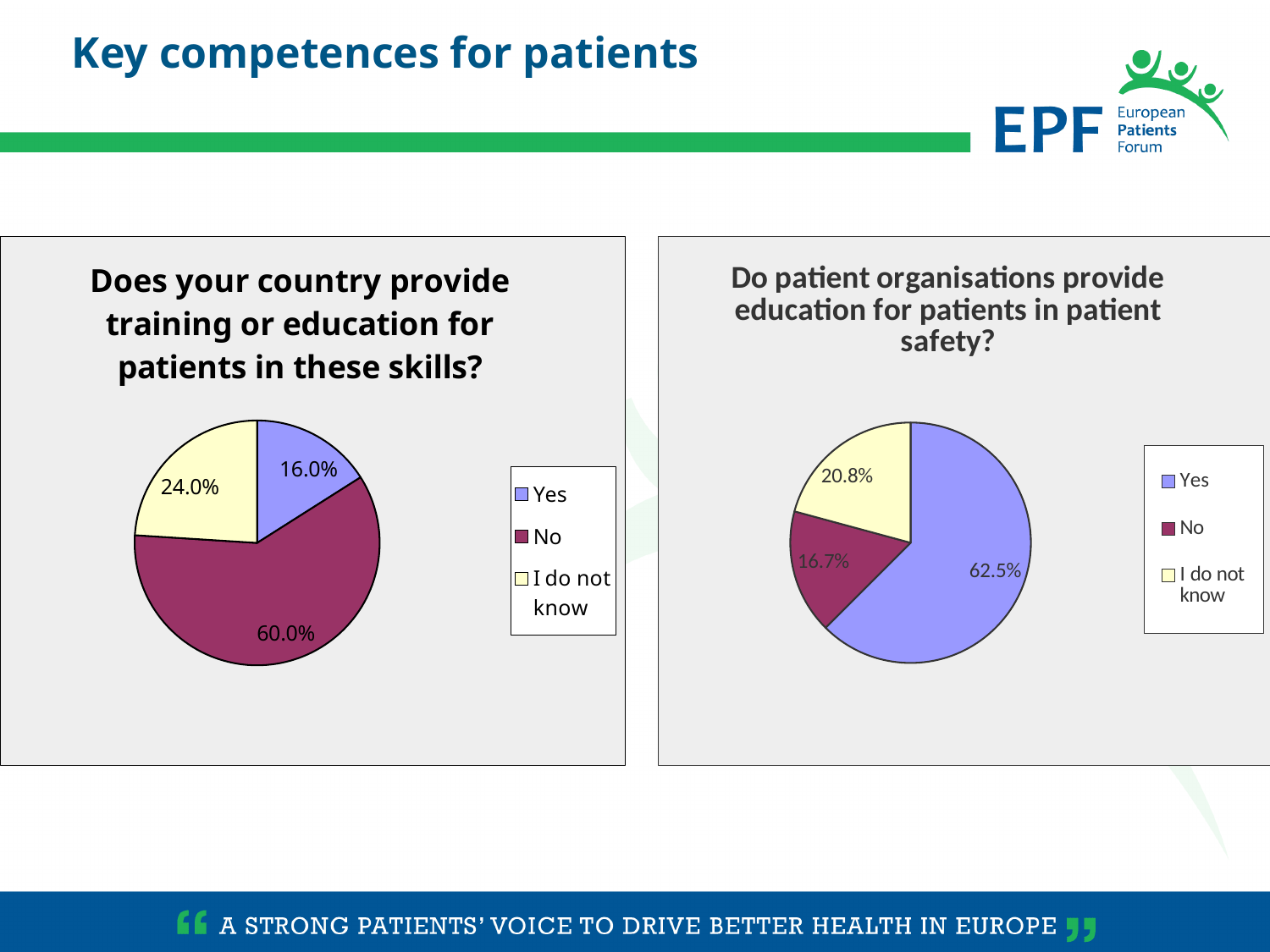
In the left chart, which response has the largest share? No In the right chart, which is larger: the "I do not know" share or the "No" share? I do not know In the left chart, which response has the smallest share? Yes In the right chart, what is the difference between the "Yes" share and the "No" share? 45.8% What type of chart is used on the left side of the slide? Pie chart How many entries does the legend of the right chart list? 3 In the chart titled "Does your country provide training or education for patients in these skills?", what percentage answered "Yes"? 16.0% In the chart titled "Do patient organisations provide education for patients in patient safety?", what percentage answered "I do not know"? 20.8% In the chart titled "Does your country provide training or education for patients in these skills?", what percentage answered "No"? 60.0% In the chart titled "Do patient organisations provide education for patients in patient safety?", what percentage answered "Yes"? 62.5% In the right chart, which response has the smallest share? No In the left chart, what is the difference between the "I do not know" share and the "Yes" share? 8.0%